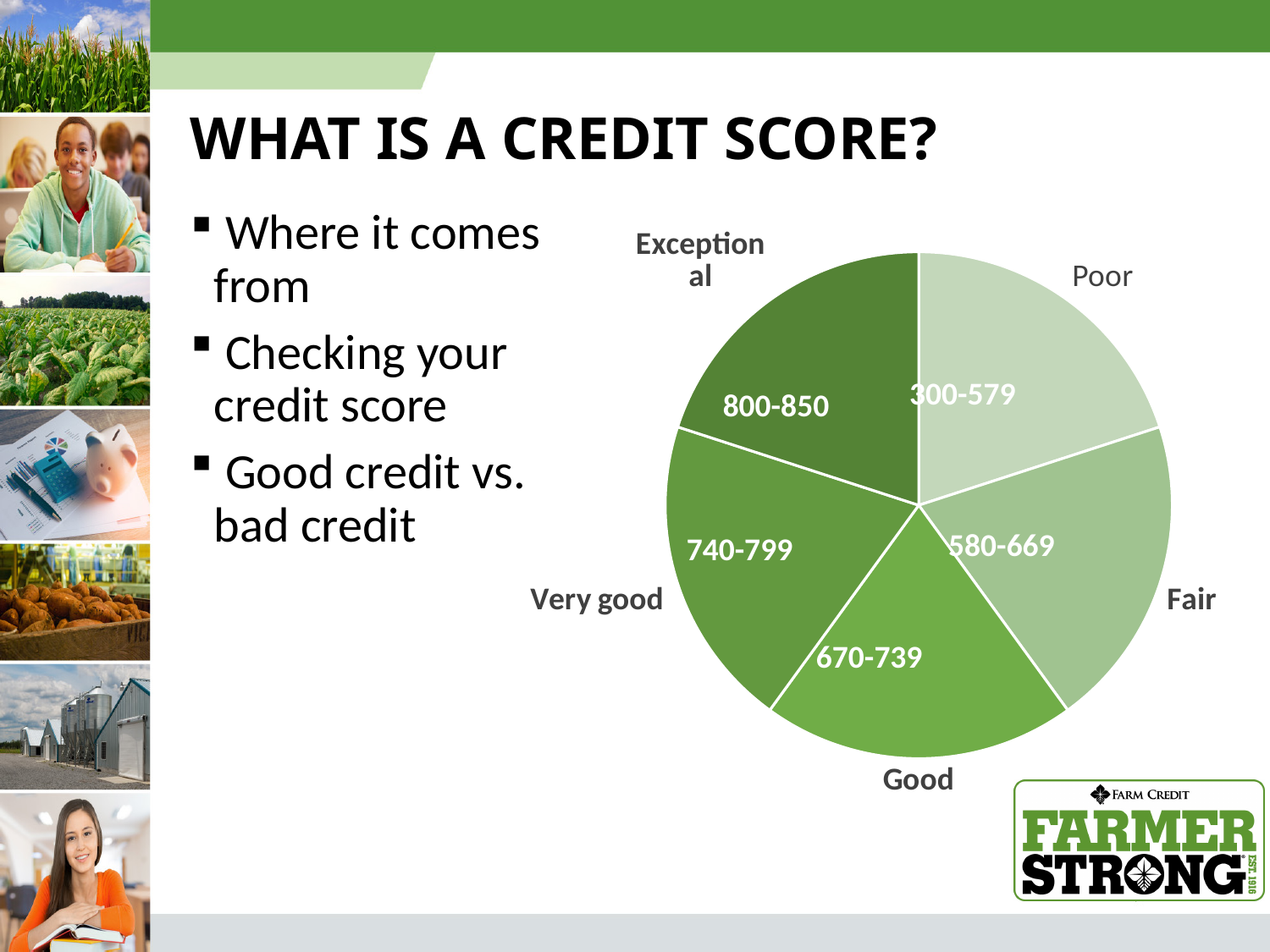
What kind of chart is shown on the slide? Pie chart What score range is labelled on the Good slice of the pie chart? 670-739 What score range is labelled on the Exceptional slice of the pie chart? 800-850 What score range is labelled on the Poor slice of the pie chart? 300-579 How many slices does the pie chart have? 5 Which slice of the pie chart is the lightest shade of green? Poor Which slice of the pie chart carries the label 580-669? Fair Which slice of the pie chart is the darkest shade of green? Exceptional What score range is labelled on the Fair slice of the pie chart? 580-669 Which slice of the pie chart carries the label 800-850? Exceptional What score range is labelled on the Very good slice of the pie chart? 740-799